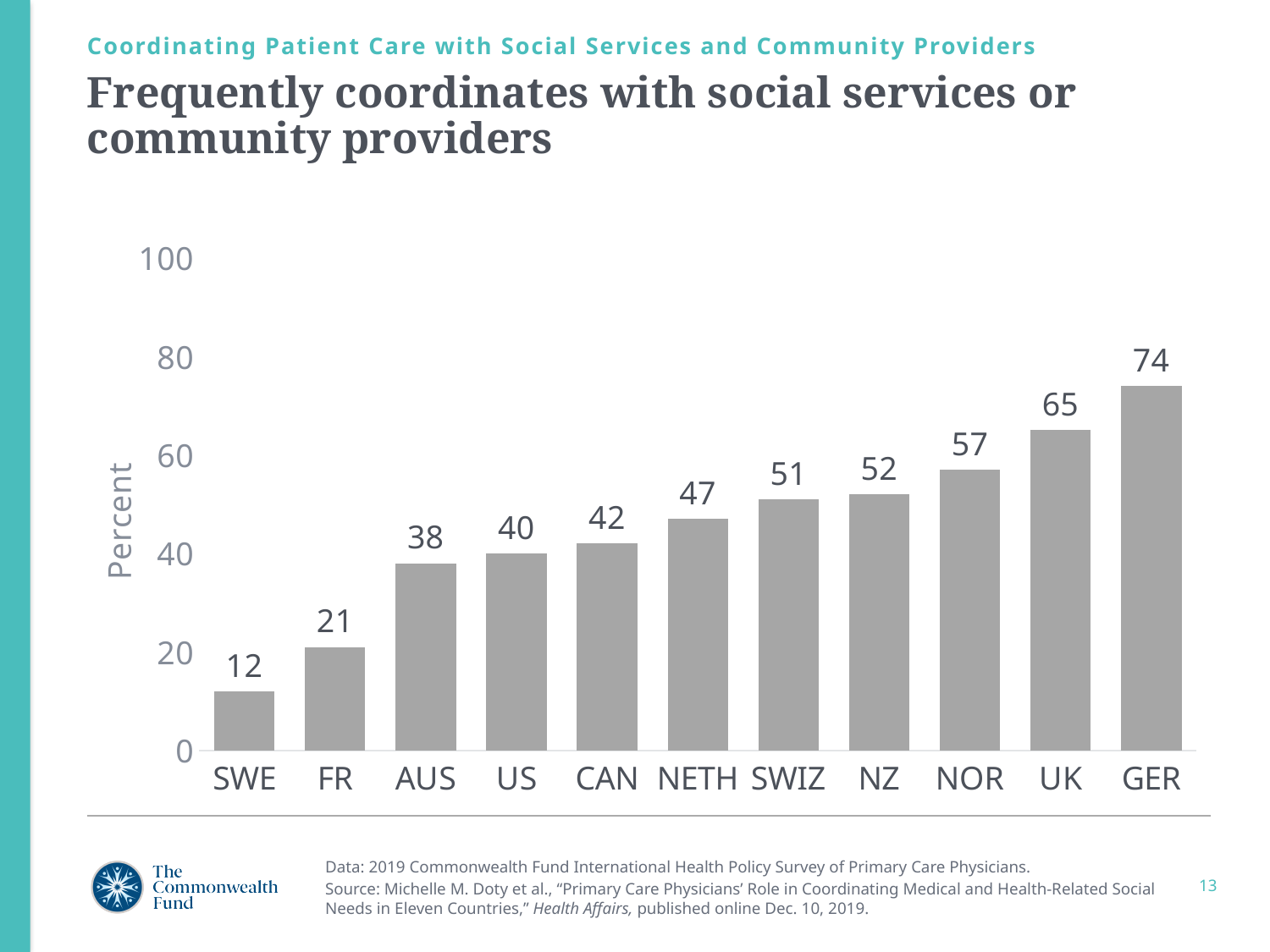
Which country has the lowest value? SWE What is the label on the vertical axis? Percent What is the value for NETH? 47 What is the value for SWE? 12 Is the value for FR greater or less than 20? greater What kind of chart is shown on the slide? bar chart What is the value for GER? 74 Do the values rise or fall from left to right along the x axis? rise Which country has the highest value? GER What is the difference between the values for UK and US? 25 Which is larger, the value for NOR or the value for CAN? NOR How many countries are shown on the chart? 11